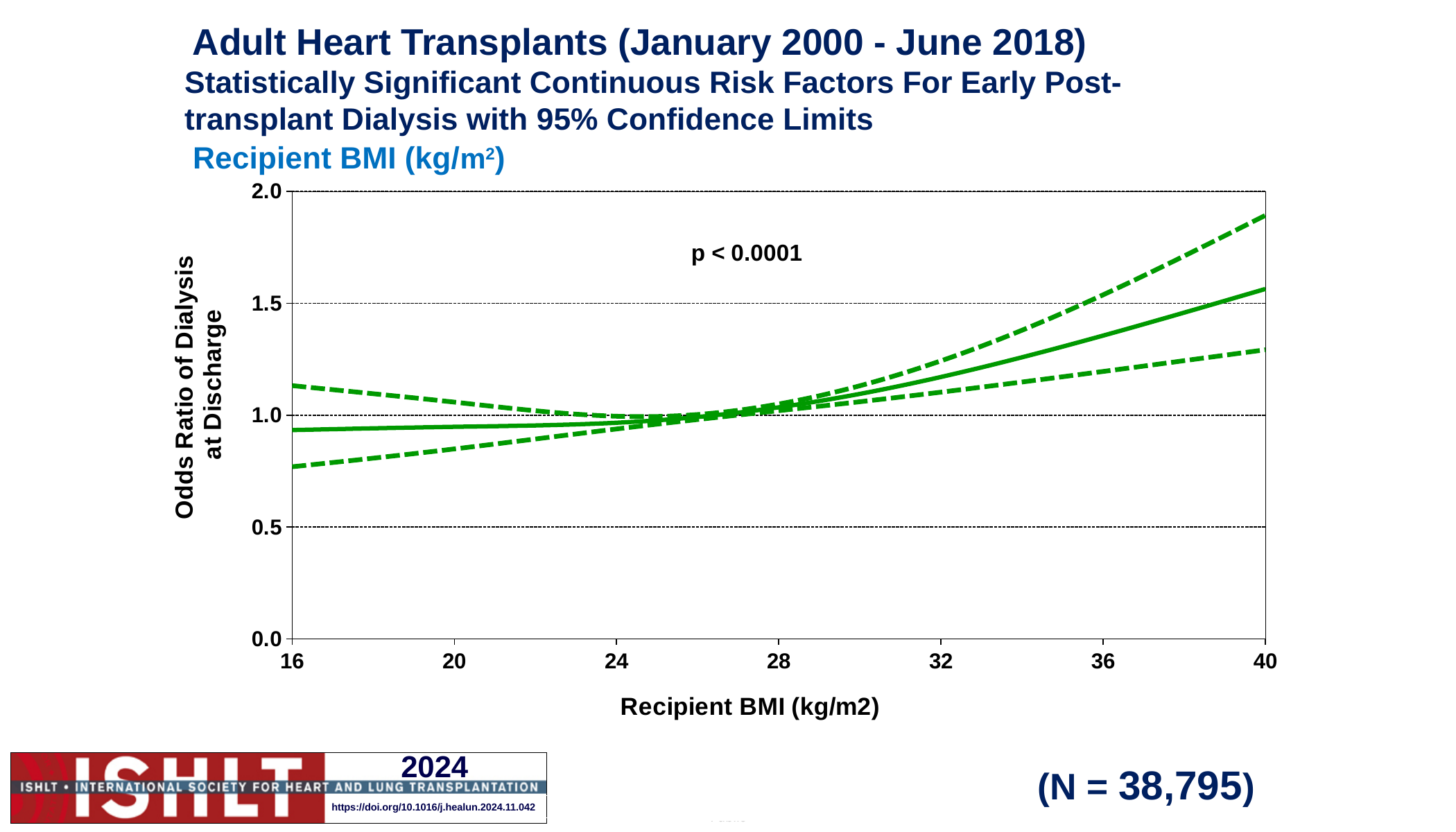
Is the lower 95% confidence limit (lower dashed line) at a recipient BMI of 16 greater or less than 0.5? greater Is the upper 95% confidence limit (upper dashed line) at a recipient BMI of 16 greater or less than 1.0? greater What kind of chart is shown on the slide? line chart What is the sample size (N) shown on the slide? 38,795 Is the odds ratio on the solid line at a recipient BMI of 16 greater or less than 1.0? less How many lines are plotted on the chart? 3 What is the label of the x axis? Recipient BMI (kg/m2) What p-value is printed on the chart? p < 0.0001 Does the odds ratio of dialysis at discharge (solid line) rise or fall as recipient BMI increases from 16 to 40? rise